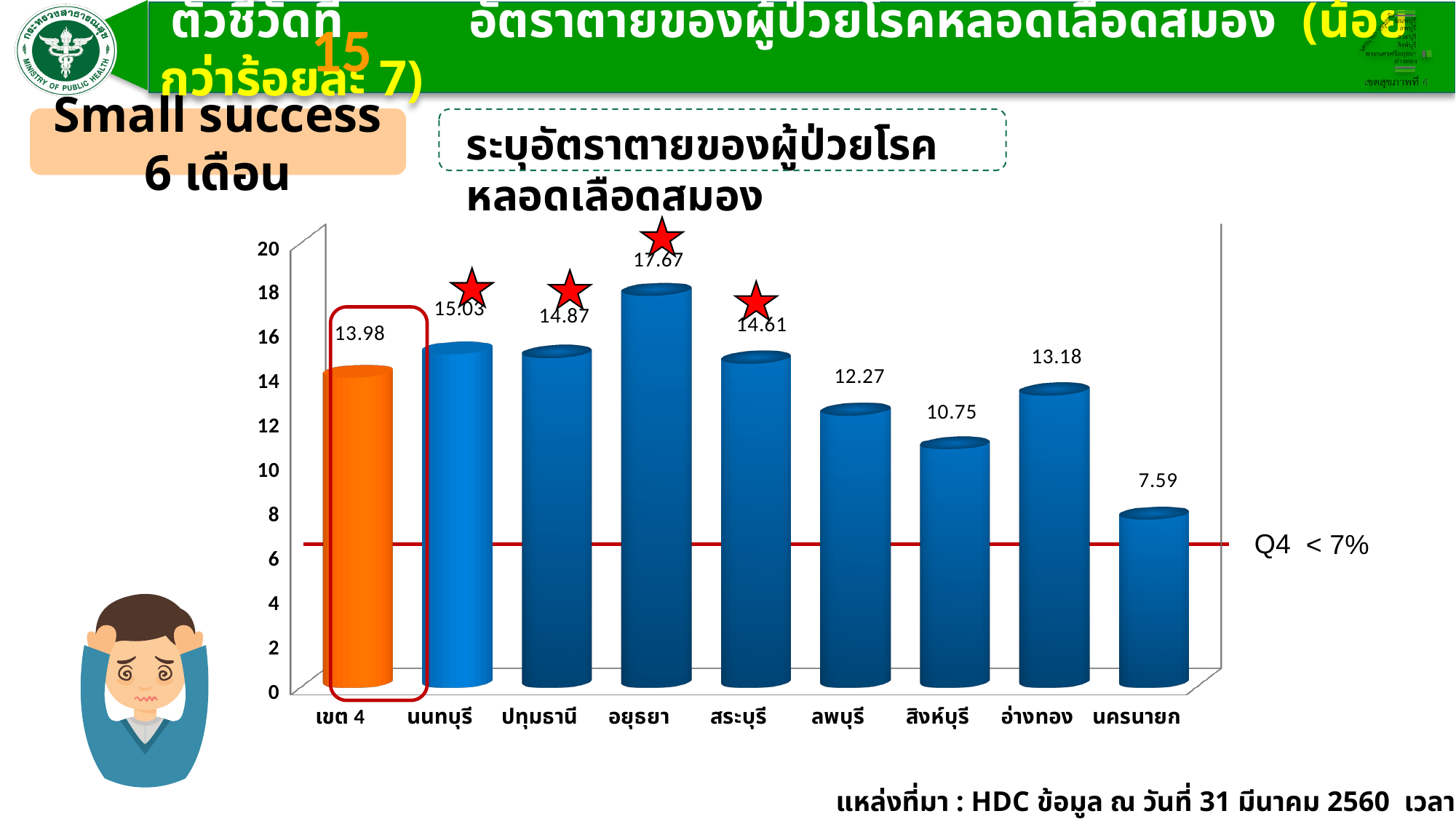
What kind of chart is shown on the slide? bar chart What is the difference between the values for นนทบุรี and เขต 4? 1.05 What is the value shown for สิงห์บุรี? 10.75 Which is larger, the value for ลพบุรี or the value for อ่างทอง? อ่างทอง Which category has the highest value? อยุธยา What is the difference between the values for อยุธยา and นครนายก? 10.08 What is the value shown for เขต 4? 13.98 What is the value shown for อยุธยา? 17.67 Which category has the lowest value? นครนายก What label is written next to the horizontal red line on the chart? Q4 < 7% How many categories are shown on the x axis? 9 What is the value shown for นครนายก? 7.59